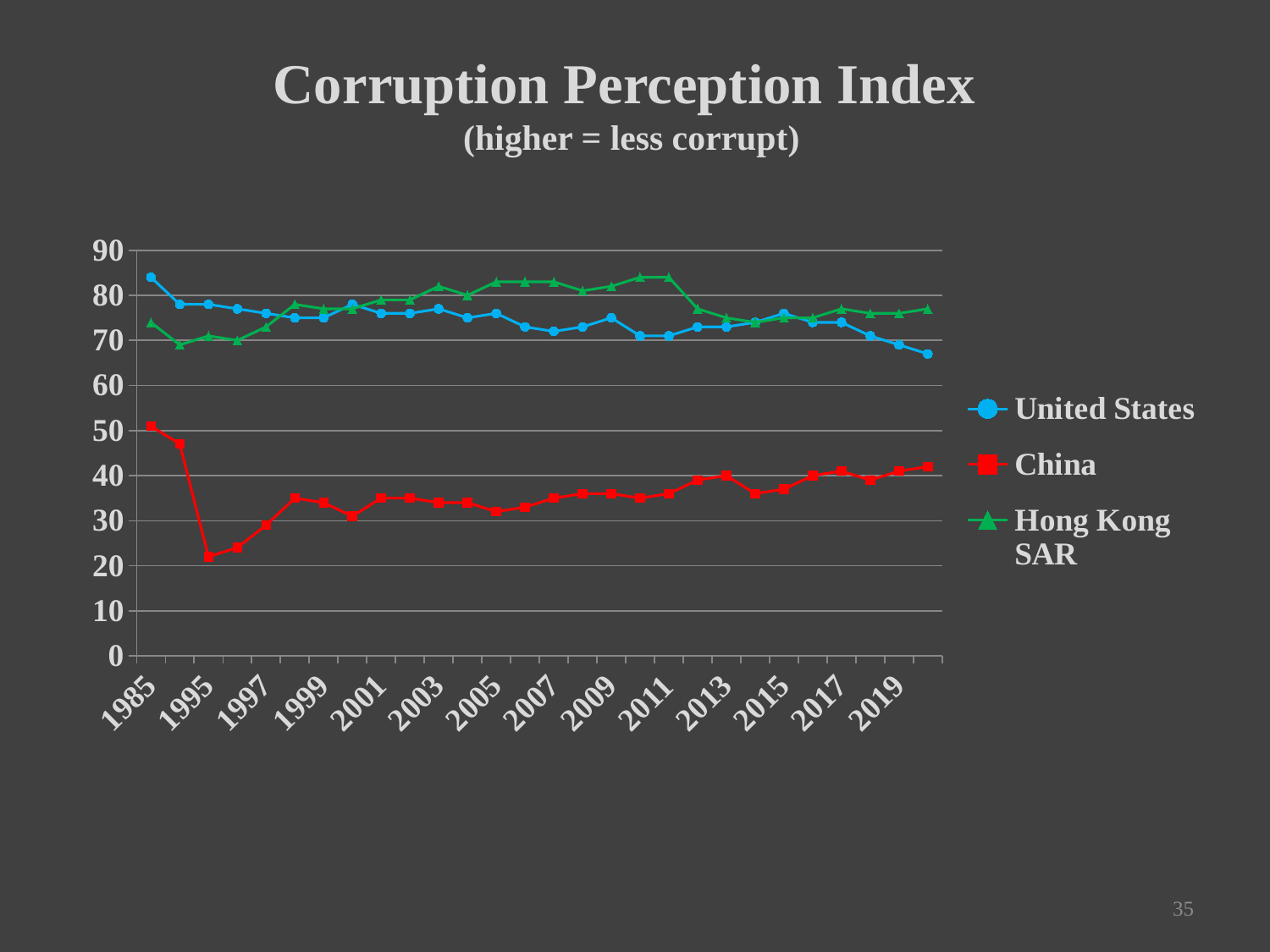
In 2019, which is larger: the value for the United States or the value for China? United States Is the value for Hong Kong SAR in 2011 greater or less than 80? greater Is the value for China in 2013 greater or less than 30? greater In 1995, which is larger: the value for the United States or the value for Hong Kong SAR? United States Does the value for the United States rise or fall from 2015 to 2019? fall What kind of chart is shown on the slide? line chart Is the value for the United States in 1985 greater or less than 80? greater What is the subtitle shown under the chart title? (higher = less corrupt) How many series does the legend list? 3 Which series has the lowest values across the whole chart? China